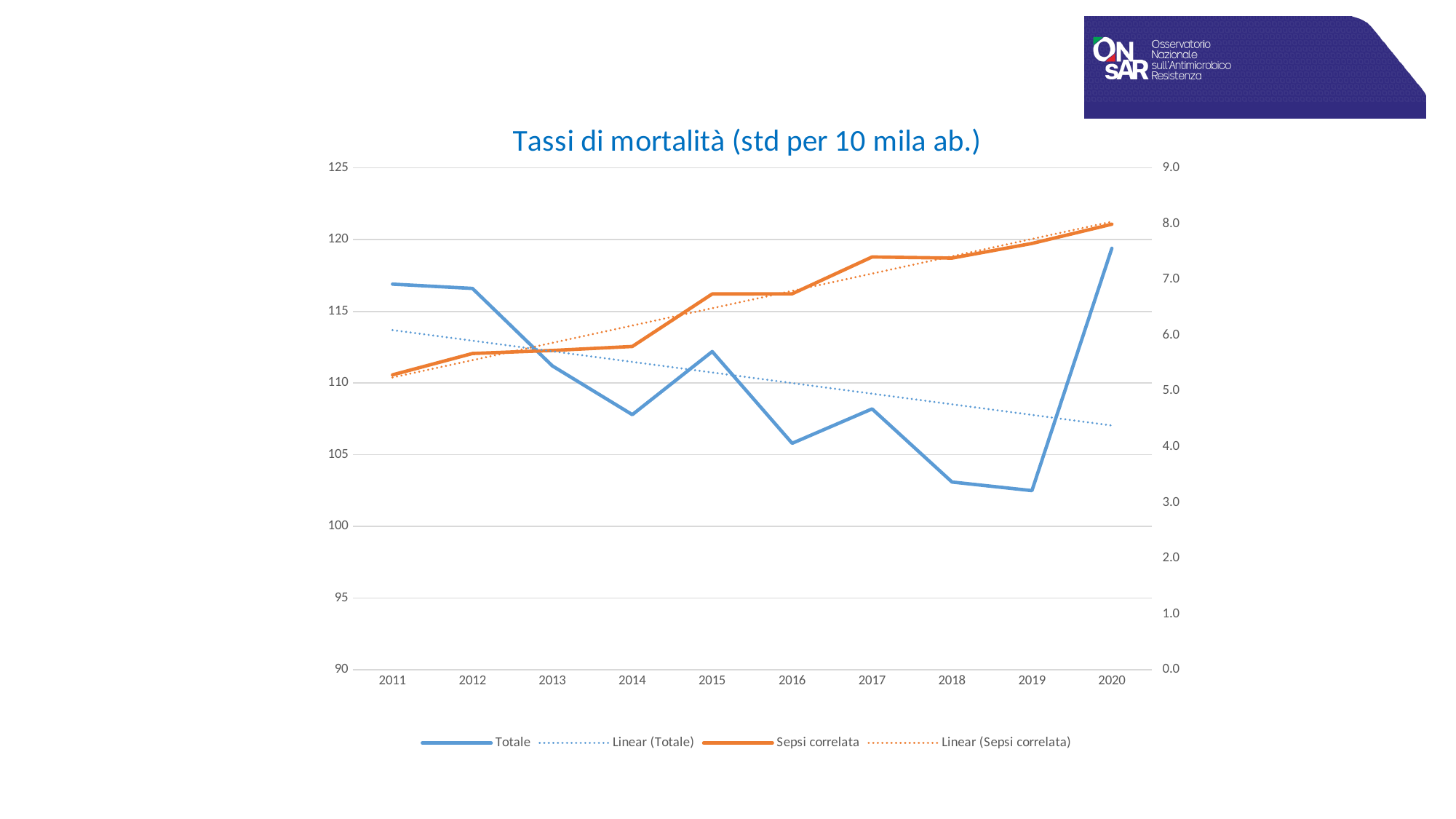
Which is larger, the Totale value for 2011 or for 2016? 2011 In which year is the Totale series at its highest? 2020 Is the Sepsi correlata value for 2020 greater or less than 7.0 on the right axis? greater How many years are shown on the x axis? 10 What is the title of the chart? Tassi di mortalità (std per 10 mila ab.) In which year is the Sepsi correlata series at its highest? 2020 How many entries does the legend list? 4 Is the Totale value for 2019 greater or less than 105? less In which year is the Sepsi correlata series at its lowest? 2011 Is the Totale value for 2020 greater or less than 115? greater Does the Sepsi correlata series generally rise or fall from 2011 to 2020? rise What kind of chart is shown on the slide? line chart